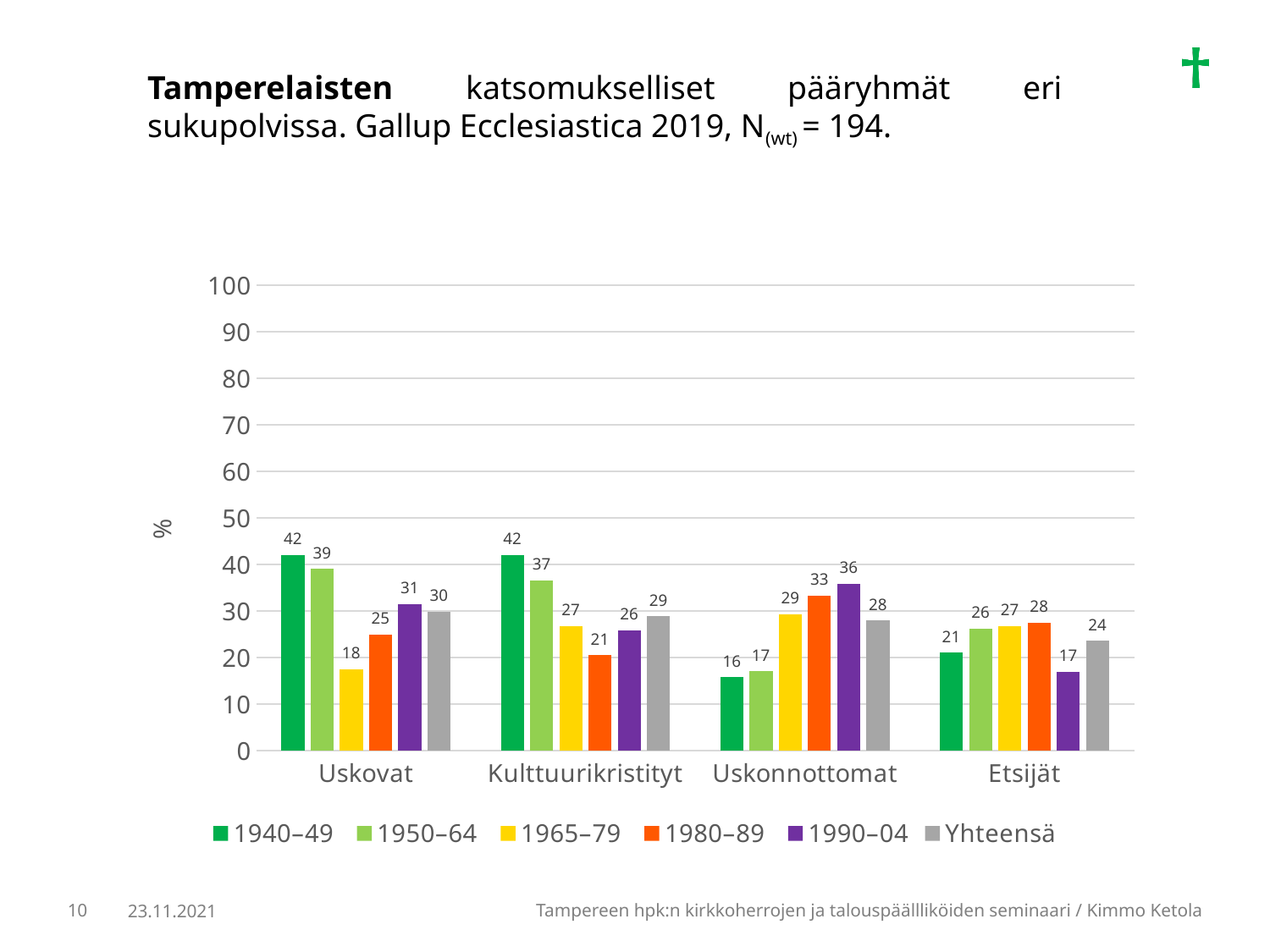
How many categories are shown on the x axis? 4 Is the 1940–49 value for Uskonnottomat greater or less than 20? less What is the Yhteensä value for Etsijät? 24 What is the value for the 1965–79 series in the Uskovat category? 18 Which series has the highest value in the Uskonnottomat category? 1990–04 What is the difference between the 1940–49 and 1965–79 values in the Kulttuurikristityt category? 15 Which is larger: the 1980–89 value for Uskovat or the 1980–89 value for Uskonnottomat? Uskonnottomat What is the label on the vertical axis? % How many series does the legend list? 6 What is the value for the 1990–04 series in the Uskonnottomat category? 36 Which series has the lowest value in the Etsijät category? 1990–04 What kind of chart is shown on the slide? bar chart